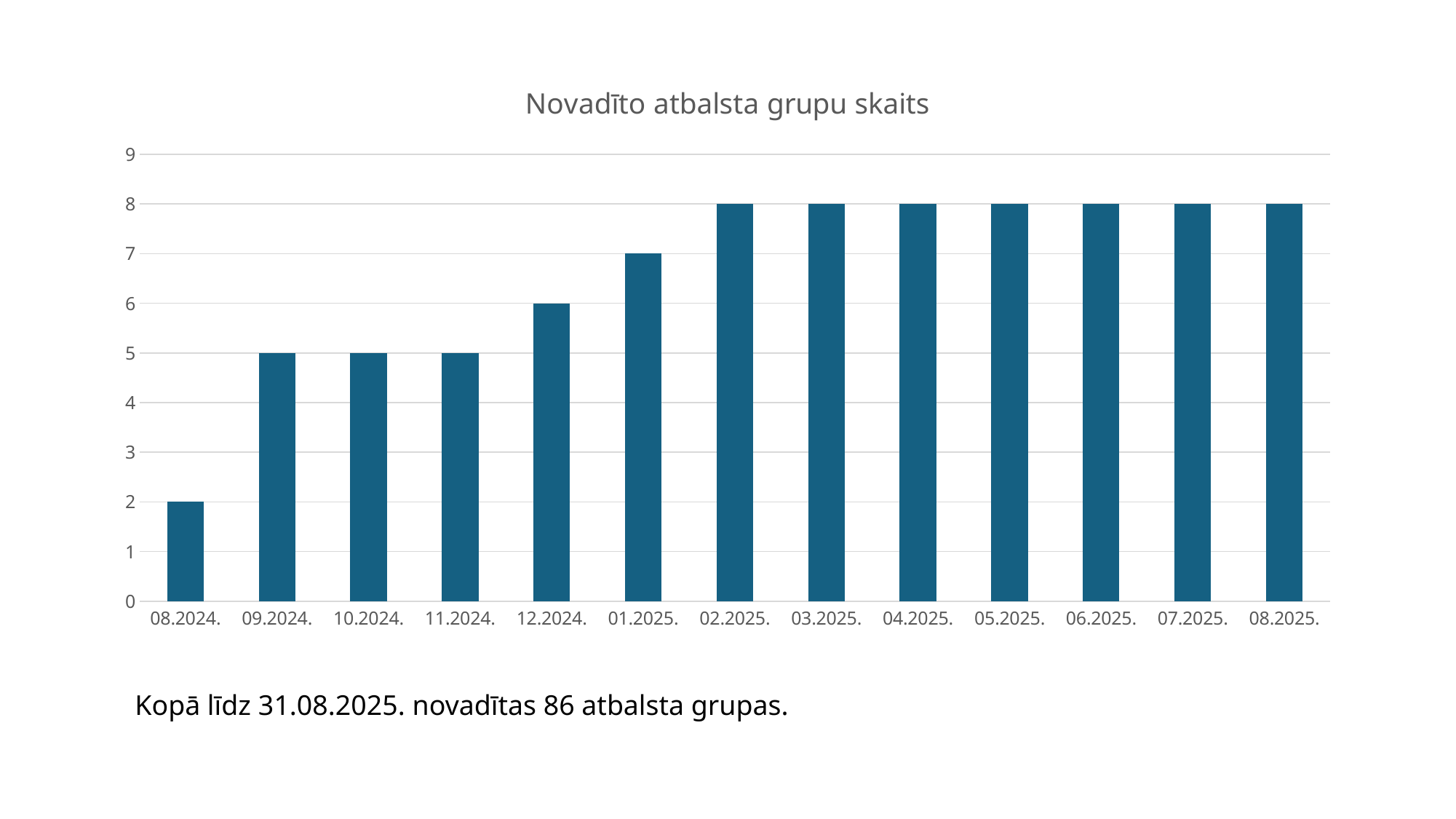
Is the value for 08.2024. greater or less than 3? less What is the value for 08.2024. in the chart? 2 What is the value for 12.2024. in the chart? 6 What is the value for 01.2025. in the chart? 7 Which month has the lowest value in the chart? 08.2024. What is the title of the chart? Novadīto atbalsta grupu skaits What is the difference between the values for 02.2025. and 12.2024.? 2 Which is larger, the value for 11.2024. or the value for 01.2025.? 01.2025. What is the value for 09.2024. in the chart? 5 How many months are shown on the x axis of the chart? 13 What is the difference between the values for 01.2025. and 08.2024.? 5 What kind of chart is shown on the slide? bar chart